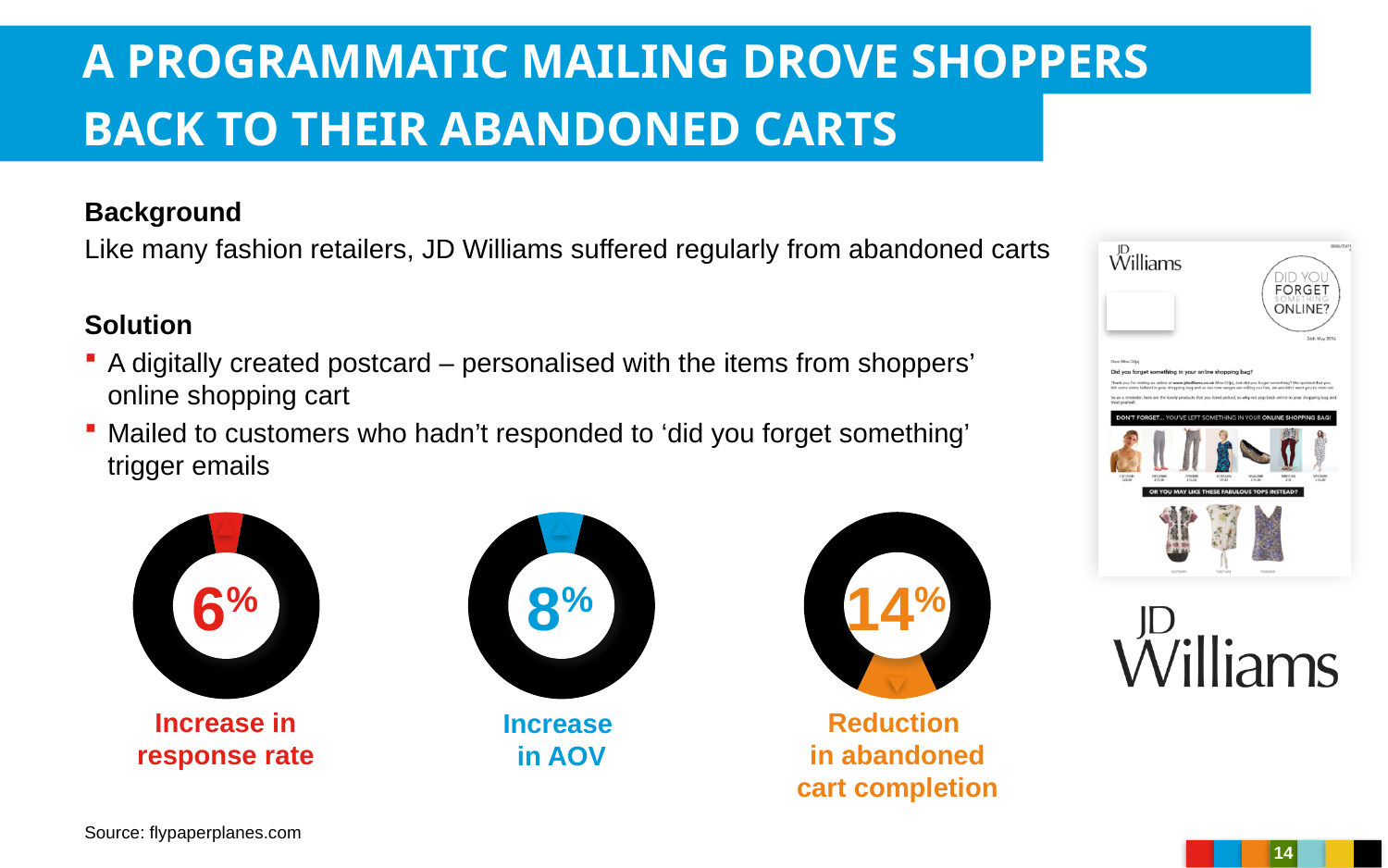
What is the difference between the value in the right donut chart (Reduction in abandoned cart completion) and the value in the left donut chart (Increase in response rate)? 8% What kind of chart is used to display the 6%, 8% and 14% figures? Donut chart What colour is the highlighted segment and value in the left donut chart (Increase in response rate)? Red What value is shown in the left donut chart labelled 'Increase in response rate'? 6% What value is shown in the right donut chart labelled 'Reduction in abandoned cart completion'? 14% Which of the three donut charts shows the lowest value? Increase in response rate What colour is the highlighted segment and value in the right donut chart (Reduction in abandoned cart completion)? Orange Which is larger: the value in the middle donut chart (Increase in AOV) or the value in the left donut chart (Increase in response rate)? Increase in AOV Which of the three donut charts shows the highest value? Reduction in abandoned cart completion What value is shown in the middle donut chart labelled 'Increase in AOV'? 8% How many donut charts are shown on the slide? 3 What is the difference between the value in the middle donut chart (Increase in AOV) and the value in the left donut chart (Increase in response rate)? 2%